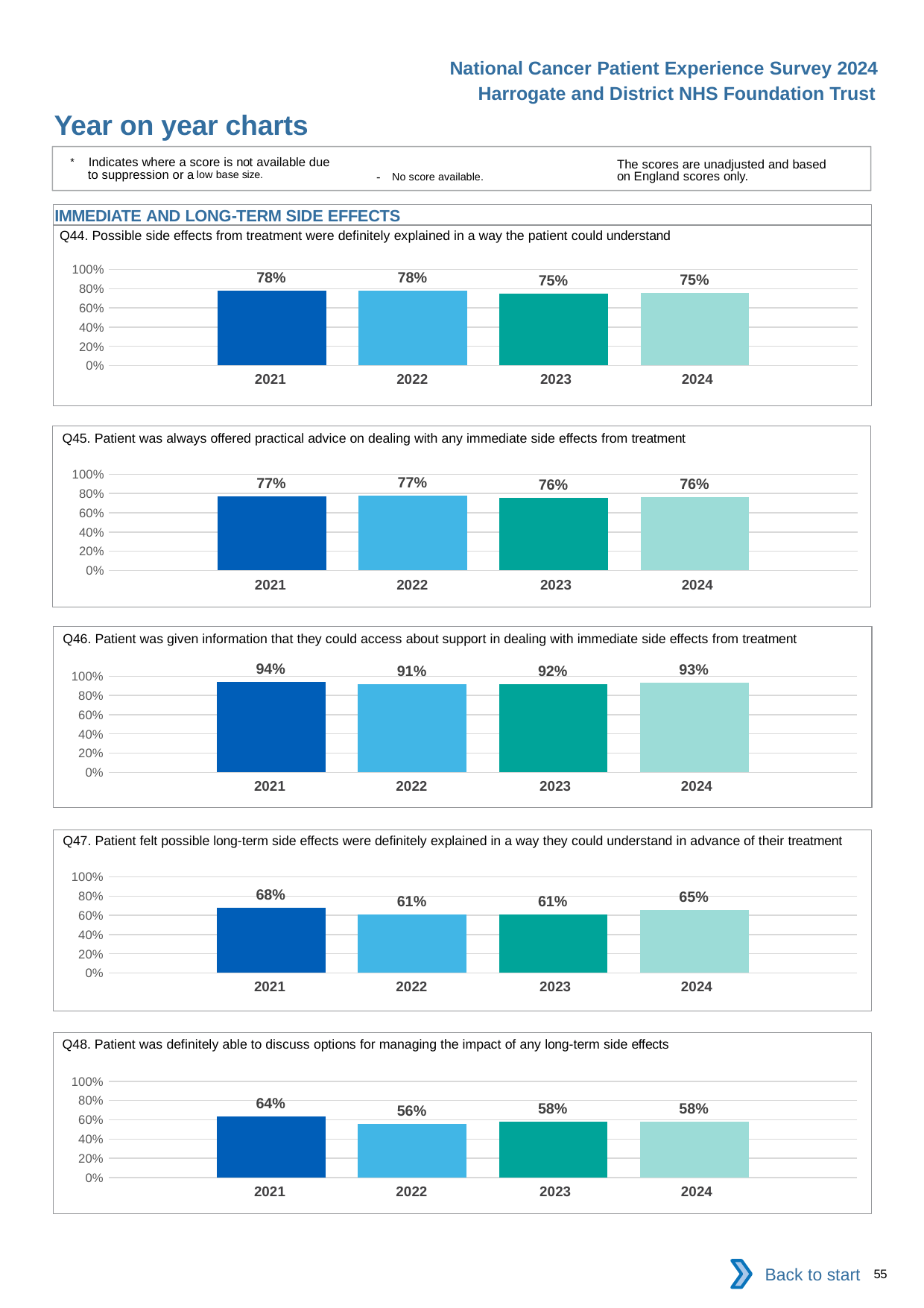
In the Q46 chart, which year has the highest value? 2021 In the Q48 chart, is the value for 2022 greater or less than 60%? less In the Q47 chart, what is the difference between the 2021 and 2022 values? 7% In the Q44 chart, what is the value for 2023? 75% How many years are shown in the Q44 chart? 4 In the Q45 chart, what is the value for 2021? 77% What kind of chart is the Q47 chart? bar chart In the Q48 chart, what is the value for 2024? 58% In the Q48 chart, which is larger, the value for 2021 or the value for 2022? 2021 In the Q46 chart, which year has the lowest value? 2022 In the Q47 chart, which year has the highest value? 2021 In the Q46 chart, what is the difference between the 2024 and 2023 values? 1%